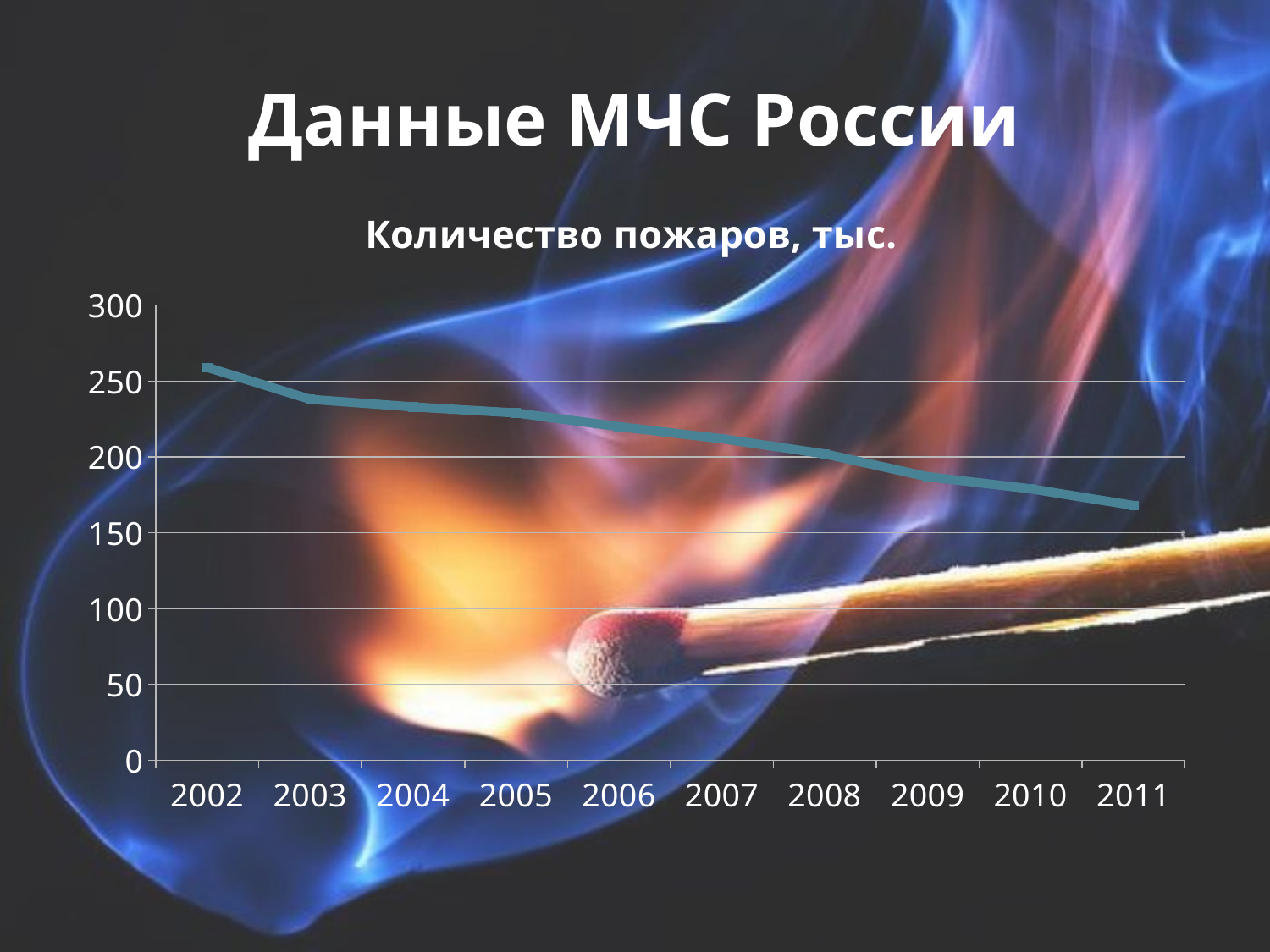
Which year has the lowest number of fires in the chart? 2011 Is the value for 2011 greater or less than 150? greater Is the value for 2005 greater or less than 250? less Which year has the larger value, 2003 or 2010? 2003 Do the values in the chart rise or fall from 2002 to 2011? fall What kind of chart is shown on the slide? line chart Is the value for 2002 greater or less than 250? greater What is the title of the chart? Количество пожаров, тыс. How many years are plotted on the x axis of the chart? 10 Which year has the highest number of fires in the chart? 2002